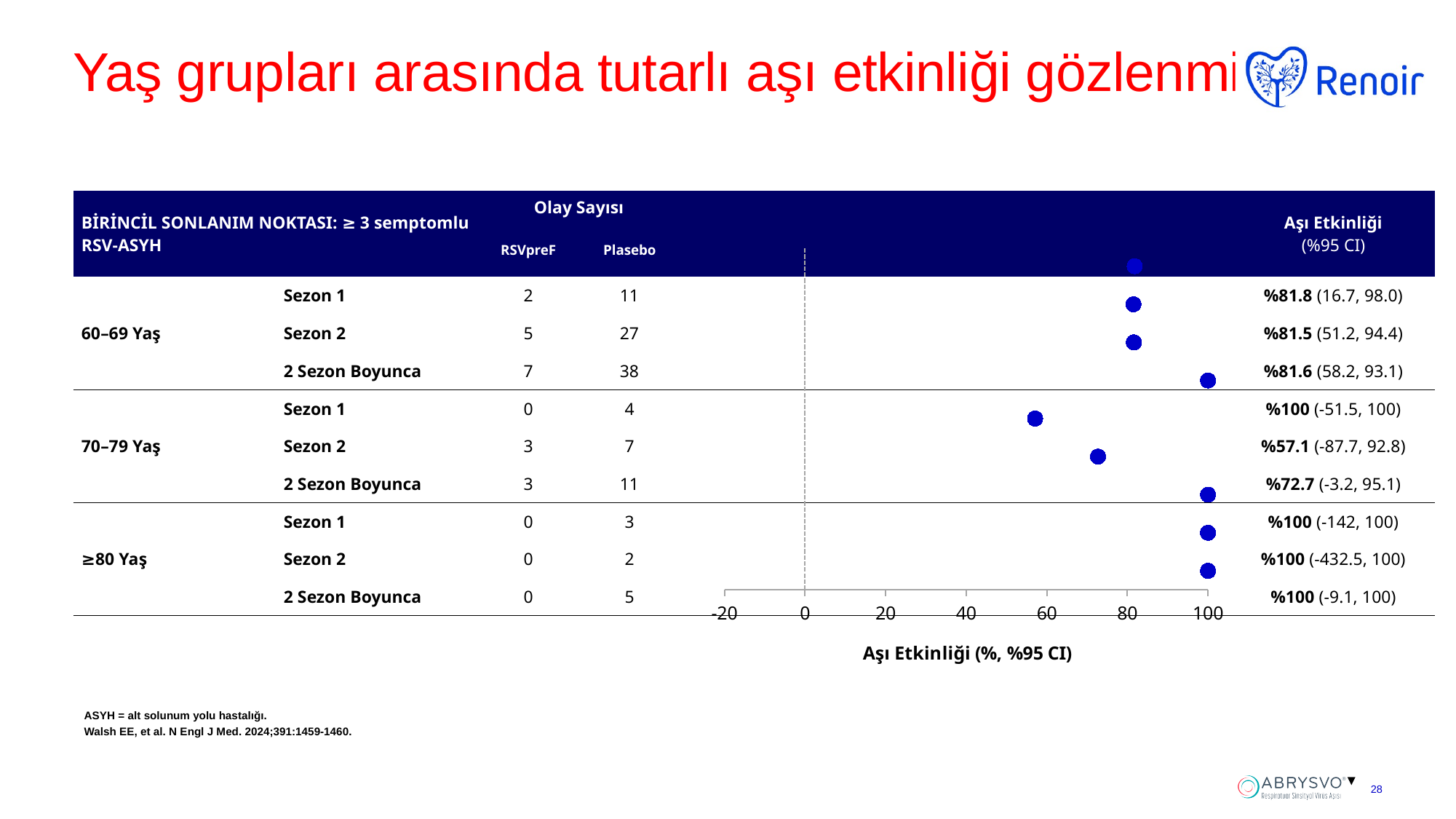
How many vaccine efficacy points are plotted on the chart? 9 What kind of chart is used to display the vaccine efficacy values? Dot (scatter) plot What is the 95% CI printed for the ≥80 Yaş group in Sezon 2? (-432.5, 100) What is the vaccine efficacy shown for the 70–79 Yaş group over 2 Sezon Boyunca? %72.7 What is the title of the chart's x axis? Aşı Etkinliği (%, %95 CI) Is the vaccine efficacy point for 70–79 Yaş Sezon 2 greater or less than 40 on the x axis? greater What is the difference between the 2 Sezon Boyunca vaccine efficacy for 60–69 Yaş (%81.6) and for 70–79 Yaş (%72.7)? 8.9 percentage points What is the vaccine efficacy (Aşı Etkinliği) shown for the 60–69 Yaş group in Sezon 1? %81.8 What is the difference between the vaccine efficacy for 60–69 Yaş Sezon 1 (%81.8) and 70–79 Yaş Sezon 2 (%57.1)? 24.7 percentage points Which age group and season has the lowest vaccine efficacy point on the chart? 70–79 Yaş, Sezon 2 Which is larger: the vaccine efficacy for 60–69 Yaş Sezon 2 or for 70–79 Yaş Sezon 2? 60–69 Yaş Sezon 2 What is the vaccine efficacy shown for the 70–79 Yaş group in Sezon 2? %57.1